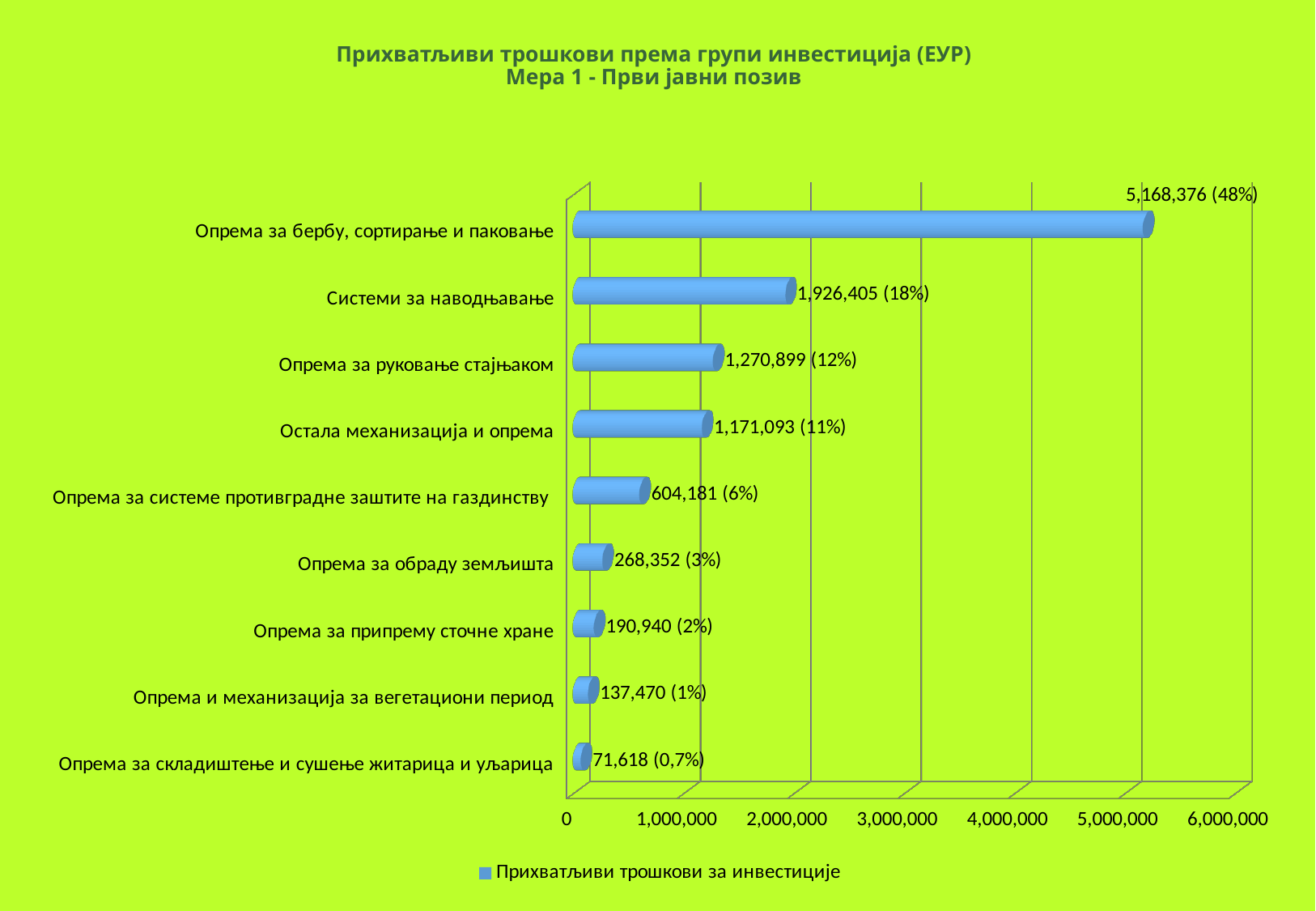
What is the value for Опрема за бербу, сортирање и паковање? 5,168,376 Which is larger: the value for Остала механизација и опрема or the value for Опрема за системе противградне заштите на газдинству? Остала механизација и опрема What is the difference between the values for Системи за наводњавање and Опрема за руковање стајњаком? 655,506 What percentage is shown for Опрема за руковање стајњаком? 12% Which category has the lowest value? Опрема за складиштење и сушење житарица и уљарица What is the legend entry of the chart? Прихватљиви трошкови за инвестиције Which category has the highest value? Опрема за бербу, сортирање и паковање Is the value for Опрема за бербу, сортирање и паковање greater or less than 5,000,000? greater What kind of chart is shown on the slide? bar chart How many categories are shown in the chart? 9 What is the value for Системи за наводњавање? 1,926,405 What is the value for Опрема за складиштење и сушење житарица и уљарица? 71,618